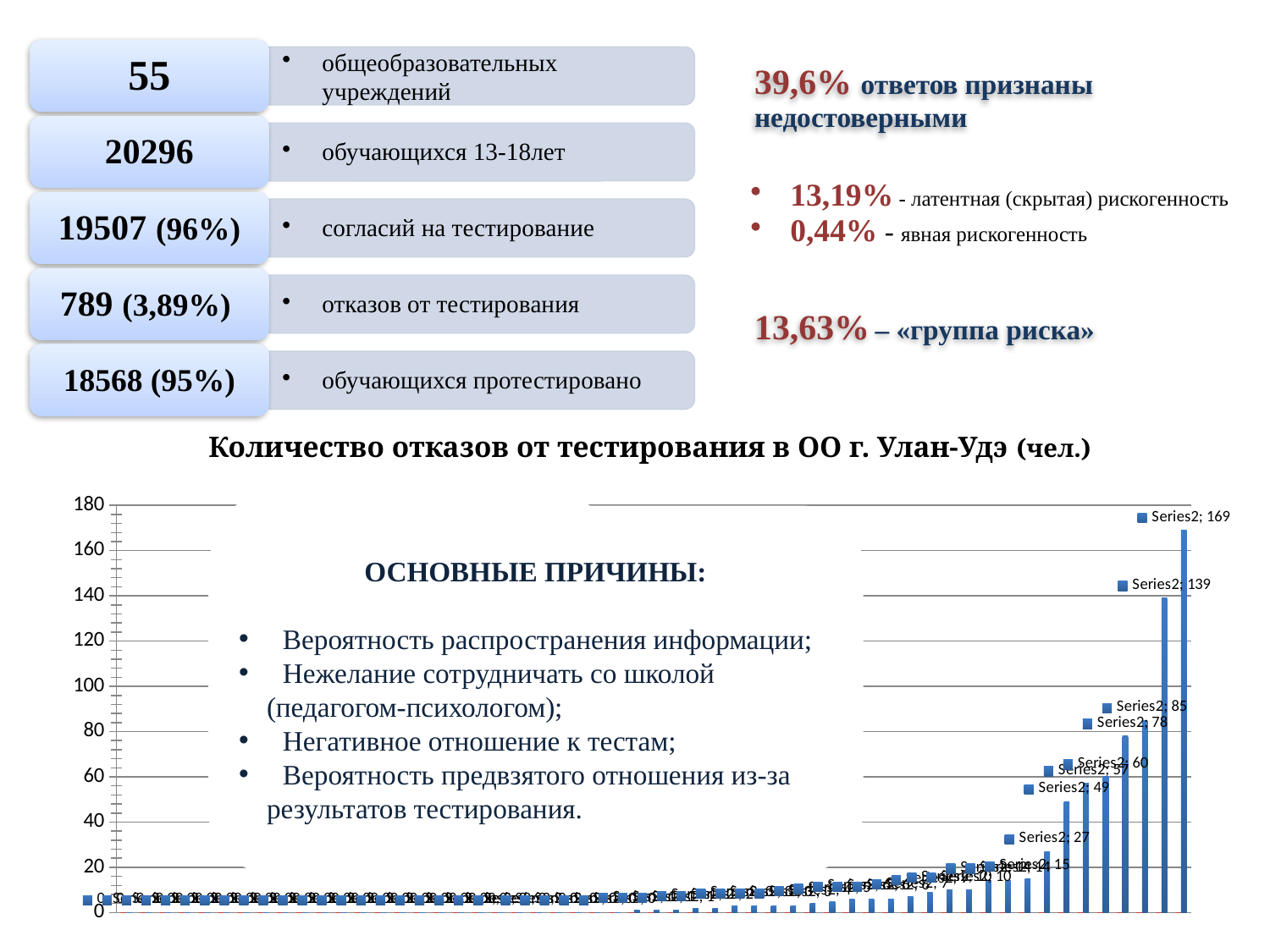
What kind of chart is shown on the slide? bar chart Is the value of the bar labelled 85 greater or less than 100? less What is the value of the second tallest bar in the chart? 139 What is the value of the bar labelled just below the 60 bar, to its left? 57 Do the bar values rise or fall from left to right along the x axis? rise Which is larger: the bar labelled 169 or the bar labelled 139? 169 Is the value of the tallest bar greater or less than 160? greater What is the highest tick value shown on the y axis of the chart? 180 What is the value of the tallest bar in the chart? 169 Which is larger: the bar labelled 78 or the bar labelled 85? 85 What is the difference between the two tallest bars in the chart (169 and 139)? 30 What is the title of the chart on the slide? Количество отказов от тестирования в ОО г. Улан-Удэ (чел.)